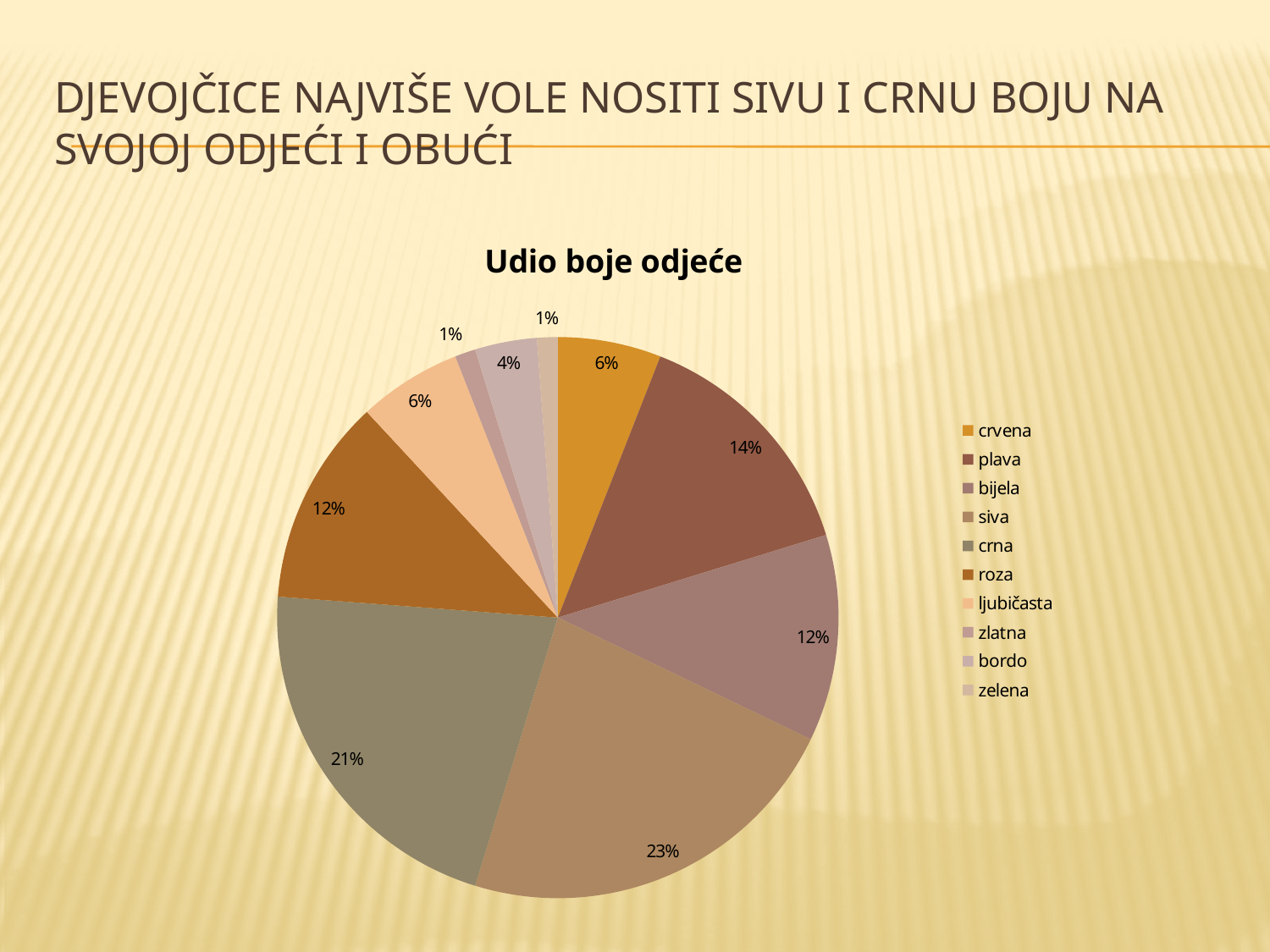
Which is larger, the share for plava or the share for bijela? plava How many categories does the legend list? 10 What is the difference between the shares of siva and crna? 2% Which colour has the largest share of the pie? siva What is the title of the chart? Udio boje odjeće What share of the pie does siva have? 23% What is the value for plava? 14% What share of the pie does crna have? 21% What kind of chart is shown on the slide? pie chart What is the value for ljubičasta? 6% What is the value for bordo? 4% What is the difference between the shares of plava and crvena? 8%